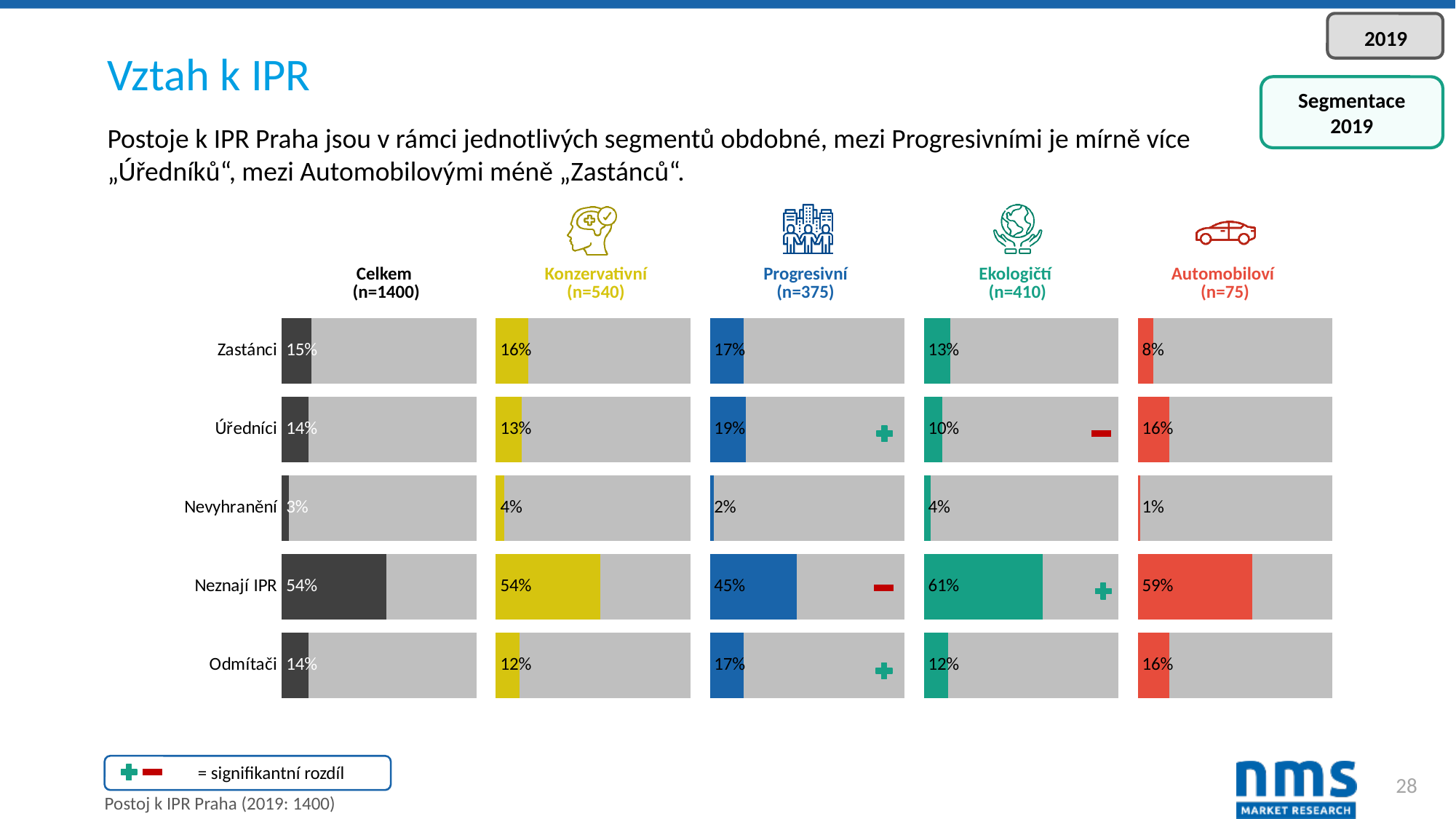
What is the sample size (n) shown for the Ekologičtí segment? n=410 In the Ekologičtí (n=410) chart, what is the difference between Neznají IPR and Zastánci? 48% In the Celkem (n=1400) chart, what is the value for Nevyhranění? 3% In the Automobiloví (n=75) chart, which category has the lowest value? Nevyhranění In the Progresivní (n=375) chart, what is the value for Úředníci? 19% In the Progresivní (n=375) chart, what is the difference between Úředníci and Nevyhranění? 17% What kind of chart is used for the Konzervativní (n=540) column? Bar chart In the Ekologičtí (n=410) chart, what is the value for Neznají IPR? 61% In the Konzervativní (n=540) chart, which category has the highest value? Neznají IPR How many categories are shown in the Celkem (n=1400) chart? 5 Which is larger: Neznají IPR in the Progresivní (n=375) chart or Neznají IPR in the Automobiloví (n=75) chart? Automobiloví In the Automobiloví (n=75) chart, what is the value for Zastánci? 8%